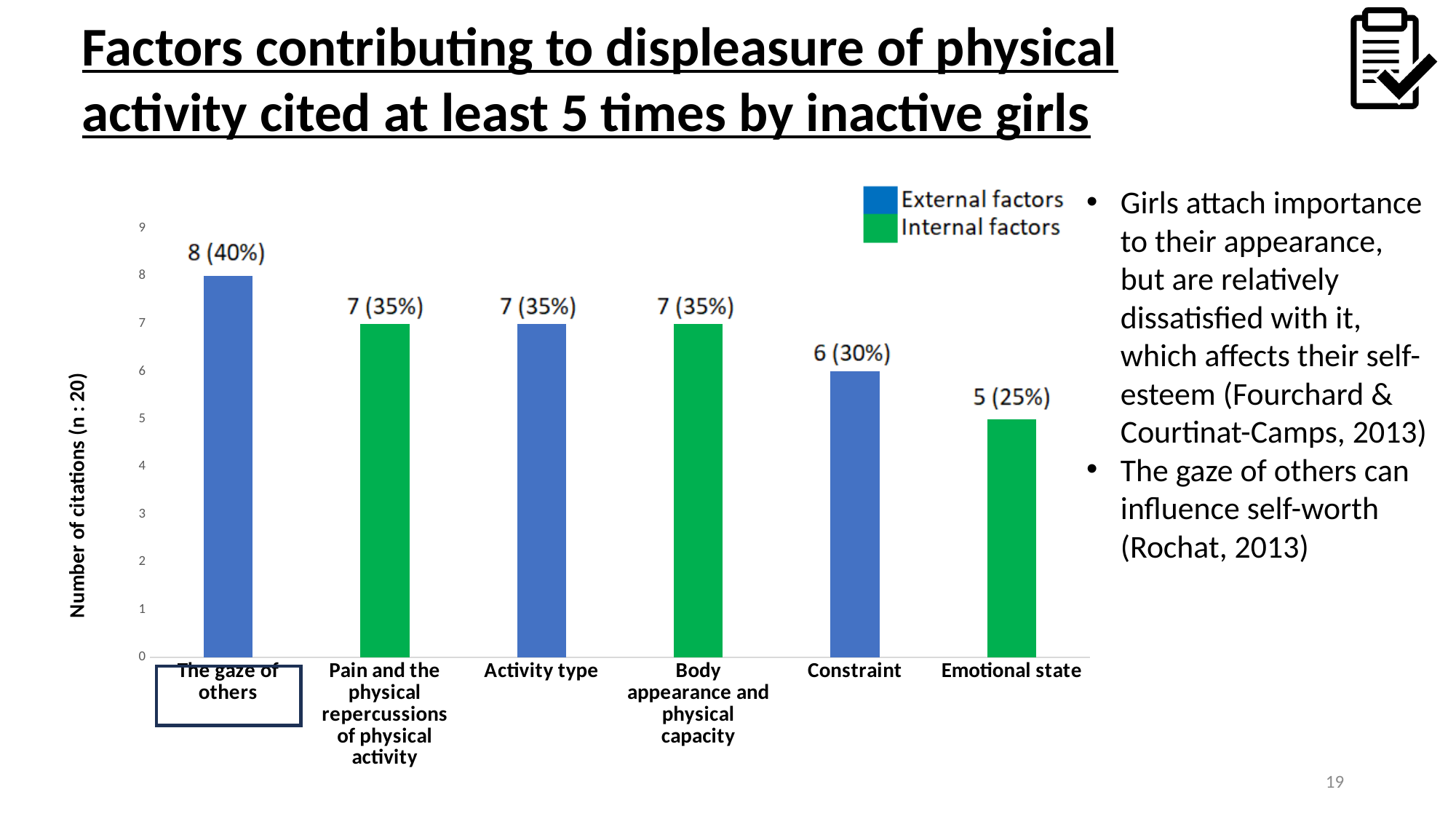
Which factor has the highest number of citations? The gaze of others What is the label of the vertical axis? Number of citations (n : 20) What is the difference in citations between The gaze of others and Emotional state? 3 Which factor has the lowest number of citations? Emotional state What is the number of citations for Constraint? 6 (30%) Which colour represents Internal factors in the legend? Green How many series does the legend list? 2 What kind of chart is shown on the slide? Bar chart What is the number of citations for Emotional state? 5 (25%) Which has more citations, Constraint or Activity type? Activity type How many factors are shown on the chart? 6 What is the number of citations for The gaze of others? 8 (40%)